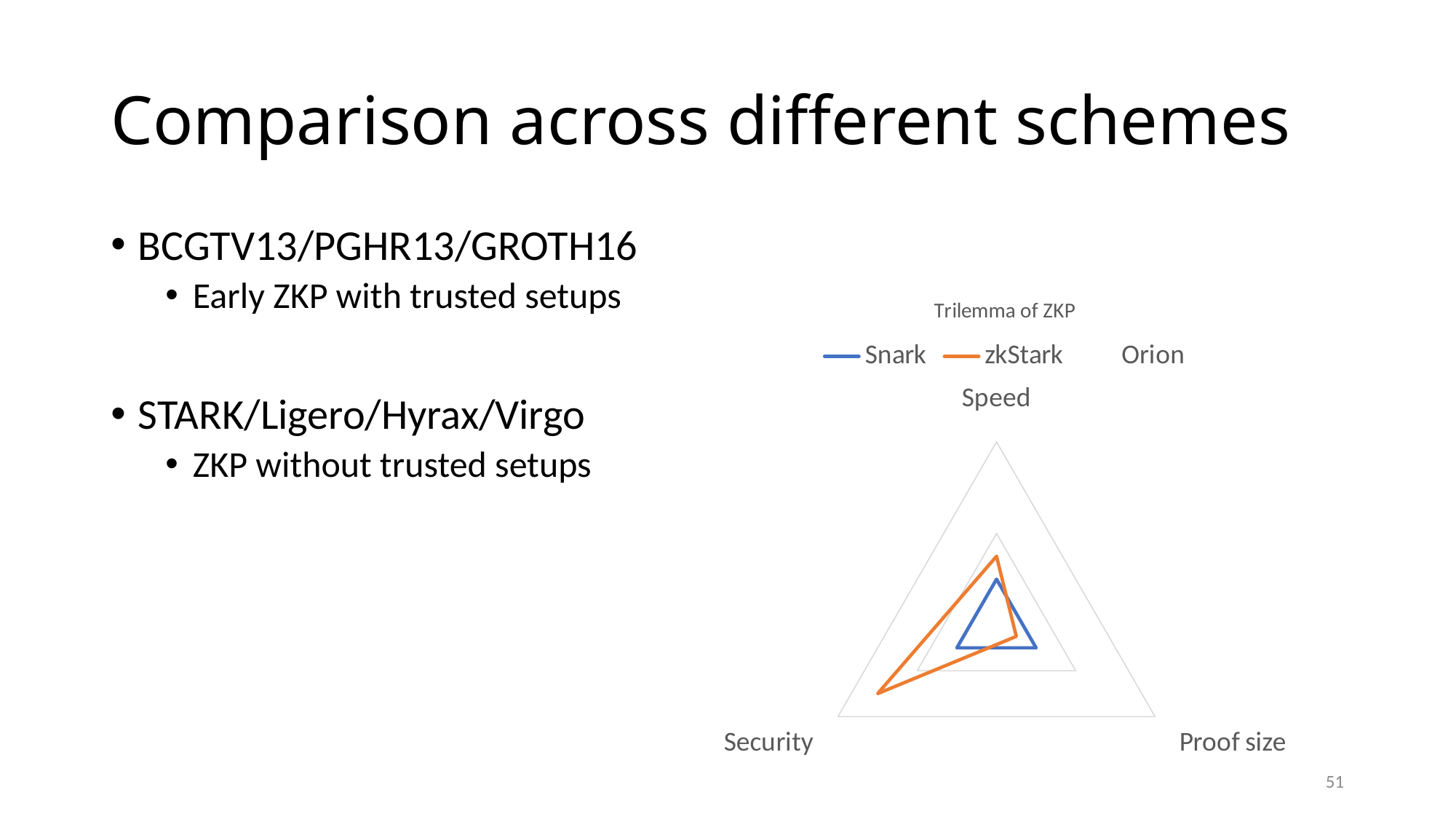
On the Security axis, which series has the larger value, Snark or zkStark? zkStark Which series is drawn in orange in the chart? zkStark What is the title of the chart on the slide? Trilemma of ZKP What kind of chart is shown on the slide? Radar chart How many series does the chart's legend list? 3 How many axes (categories) does the radar chart have? 3 On which axis does the zkStark series reach its highest value? Security